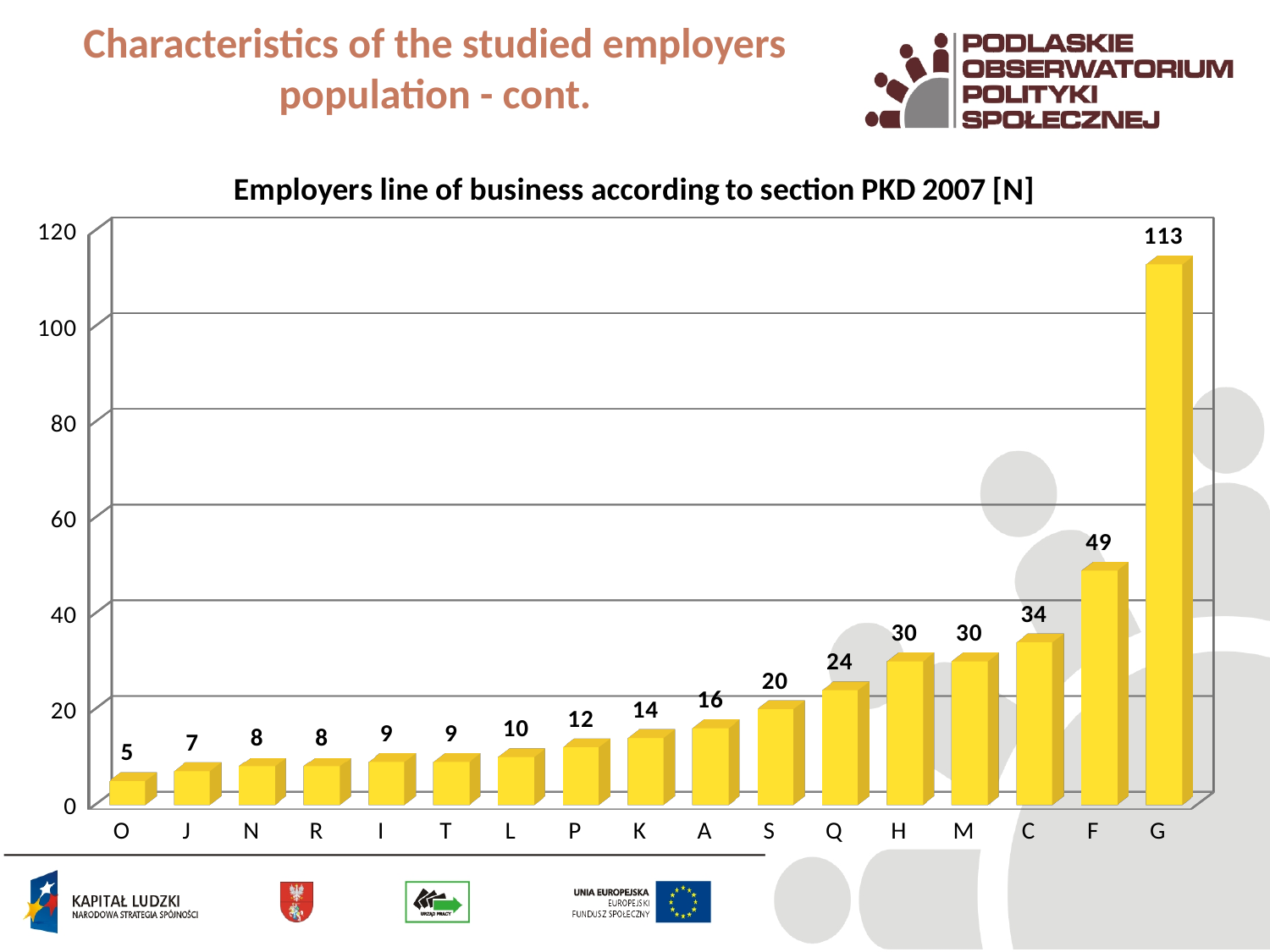
Which is larger, the value for K or the value for S? S What is the difference between the values for G and F? 64 How many sections are shown on the x axis? 17 What is the value for section Q? 24 What is the value for section G? 113 Which section has the highest value? G Do the values rise or fall from left to right along the x axis? rise Which section has the lowest value? O What kind of chart is this? bar chart Is the value for F greater or less than 40? greater What is the title of the chart? Employers line of business according to section PKD 2007 [N] What is the difference between the values for C and A? 18